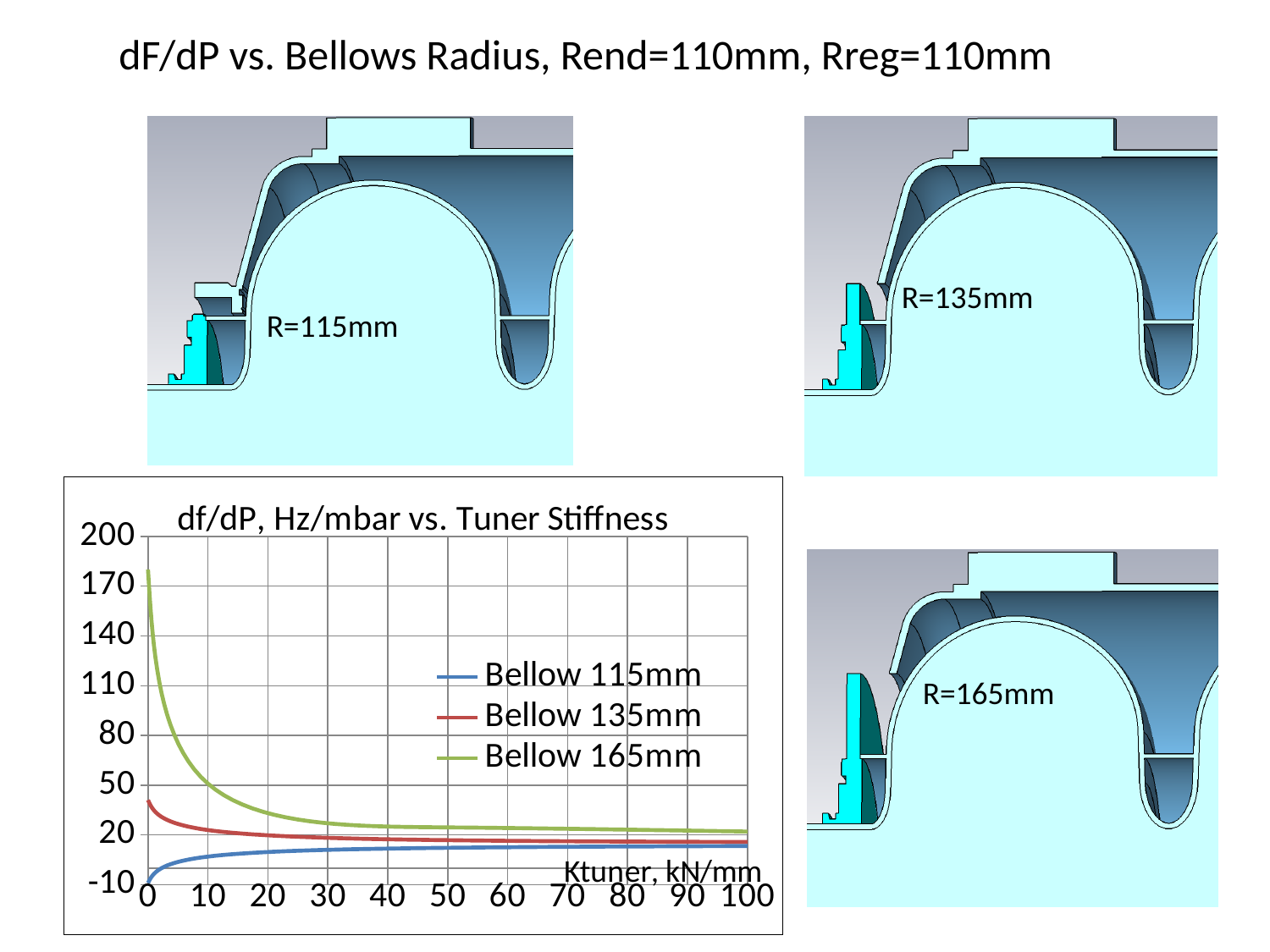
What is the label on the x axis of the chart? Ktuner, kN/mm Is the value for Bellow 135mm at Ktuner = 0 greater or less than 50? less Does the Bellow 165mm series rise or fall as Ktuner increases? fall Is the value for Bellow 165mm at Ktuner = 0 greater or less than 140? greater What is the title of the chart? df/dP, Hz/mbar vs. Tuner Stiffness What kind of chart is shown on the slide? line chart At Ktuner = 100, which series has the larger value, Bellow 165mm or Bellow 115mm? Bellow 165mm Is the value for Bellow 115mm at Ktuner = 0 greater or less than 20? less How many series does the chart legend list? 3 Does the Bellow 115mm series rise or fall as Ktuner increases? rise Which series has the highest value at Ktuner = 0? Bellow 165mm Which series has the lowest value at Ktuner = 0? Bellow 115mm